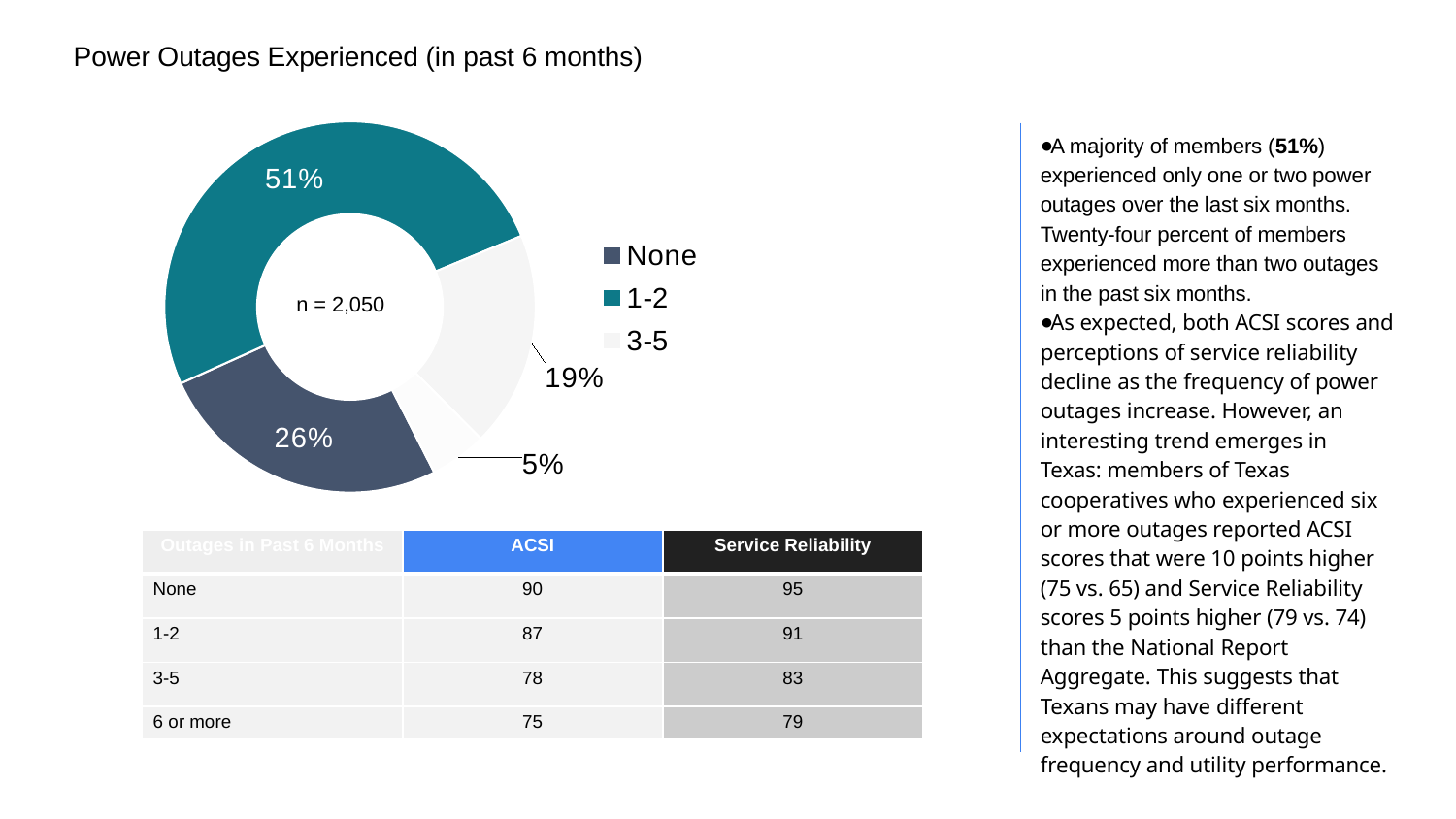
What is the value of the smallest slice in the doughnut chart? 5% Which category has the largest slice in the doughnut chart? 1-2 How many entries does the legend of the doughnut chart list? 3 What sample size is shown in the centre of the doughnut chart? n = 2,050 What percentage of the doughnut chart is the 1-2 outages slice? 51% How many percentage points larger is the 1-2 slice than the None slice? 25% How many slices does the doughnut chart have? 4 What kind of chart is shown on the slide? doughnut chart Which slice is larger in the doughnut chart, None or 3-5? None What percentage of the doughnut chart is the 3-5 outages slice? 19% How many percentage points larger is the None slice than the 3-5 slice? 7% What percentage of the doughnut chart is the None slice? 26%